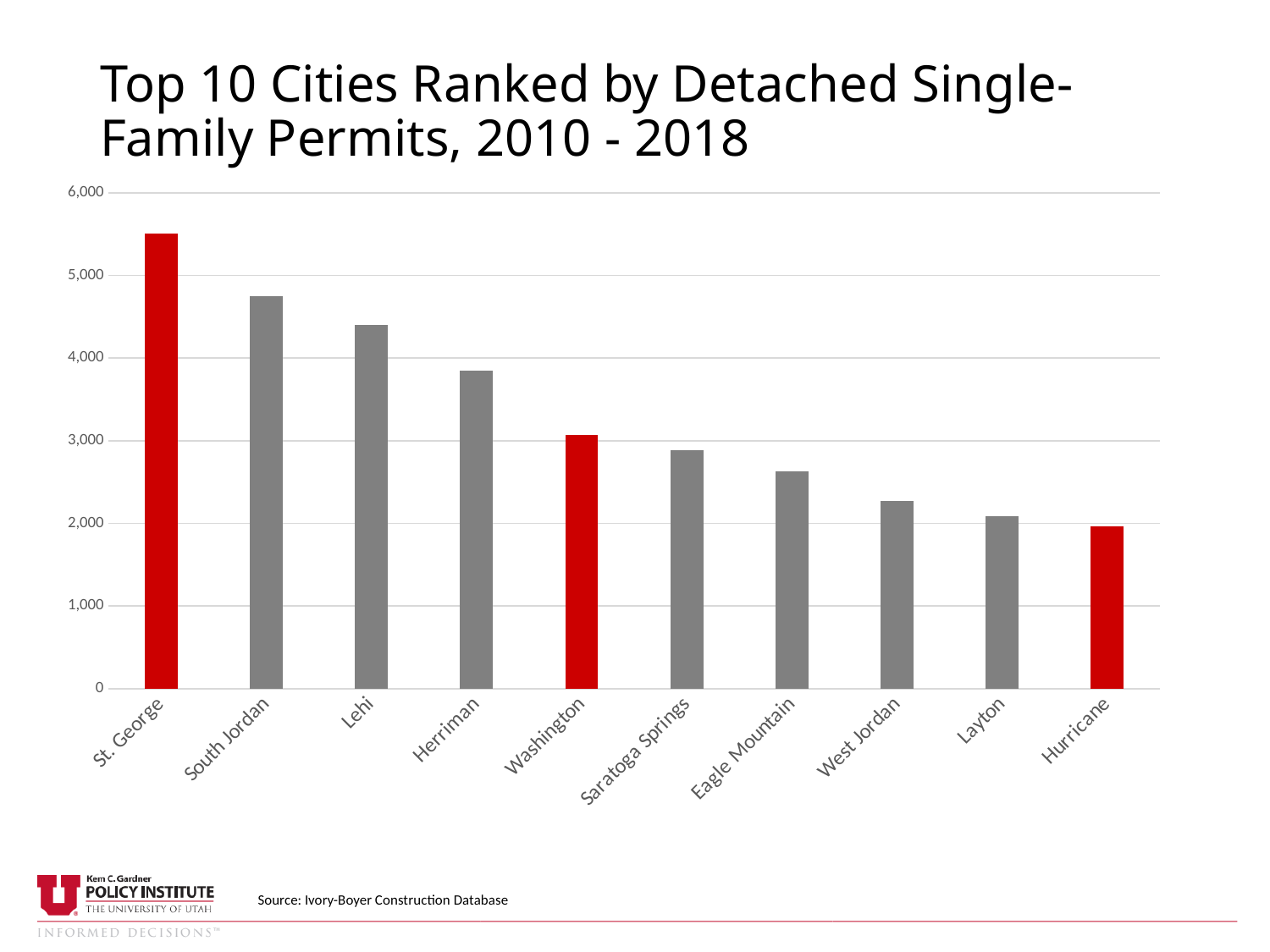
How many cities are shown in the chart? 10 Is the value for Herriman greater or less than 4,000? less Which city has more permits, South Jordan or Herriman? South Jordan Is the value for St. George greater or less than 5,000? greater Is the value for Eagle Mountain greater or less than 2,000? greater Which city has the lowest number of detached single-family permits? Hurricane What kind of chart is shown on the slide? Bar chart How many bars are coloured red in the chart? 3 Which city has the highest number of detached single-family permits? St. George Do the values rise or fall moving from left to right along the x axis? Fall